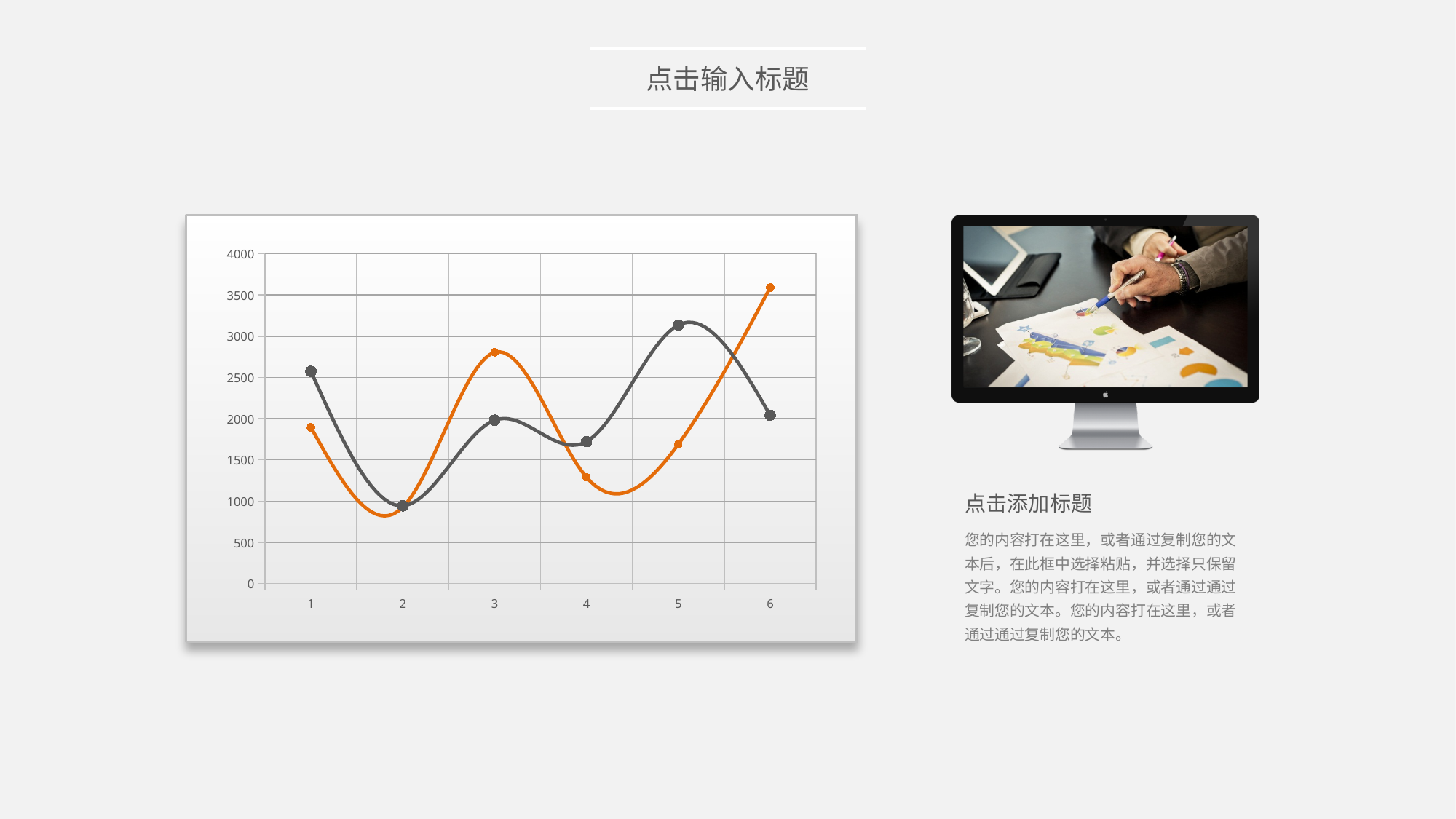
How many points are plotted along the x axis of the chart? 6 What kind of chart is shown on the slide? line chart Is the value of the orange line at point 4 greater or less than 1500? less How many lines (series) are plotted in the chart? 2 Is the value of the grey line at point 5 greater or less than 3000? greater At point 3, which line has the higher value, the orange line or the grey line? orange line At point 1, which line has the higher value, the orange line or the grey line? grey line At which x-axis point does the grey line reach its highest value? 5 Is the value of the orange line at point 6 greater or less than 3500? greater At which x-axis point does the orange line reach its highest value? 6 At which x-axis point does the grey line reach its lowest value? 2 Does the orange line rise or fall from point 4 to point 6? rise